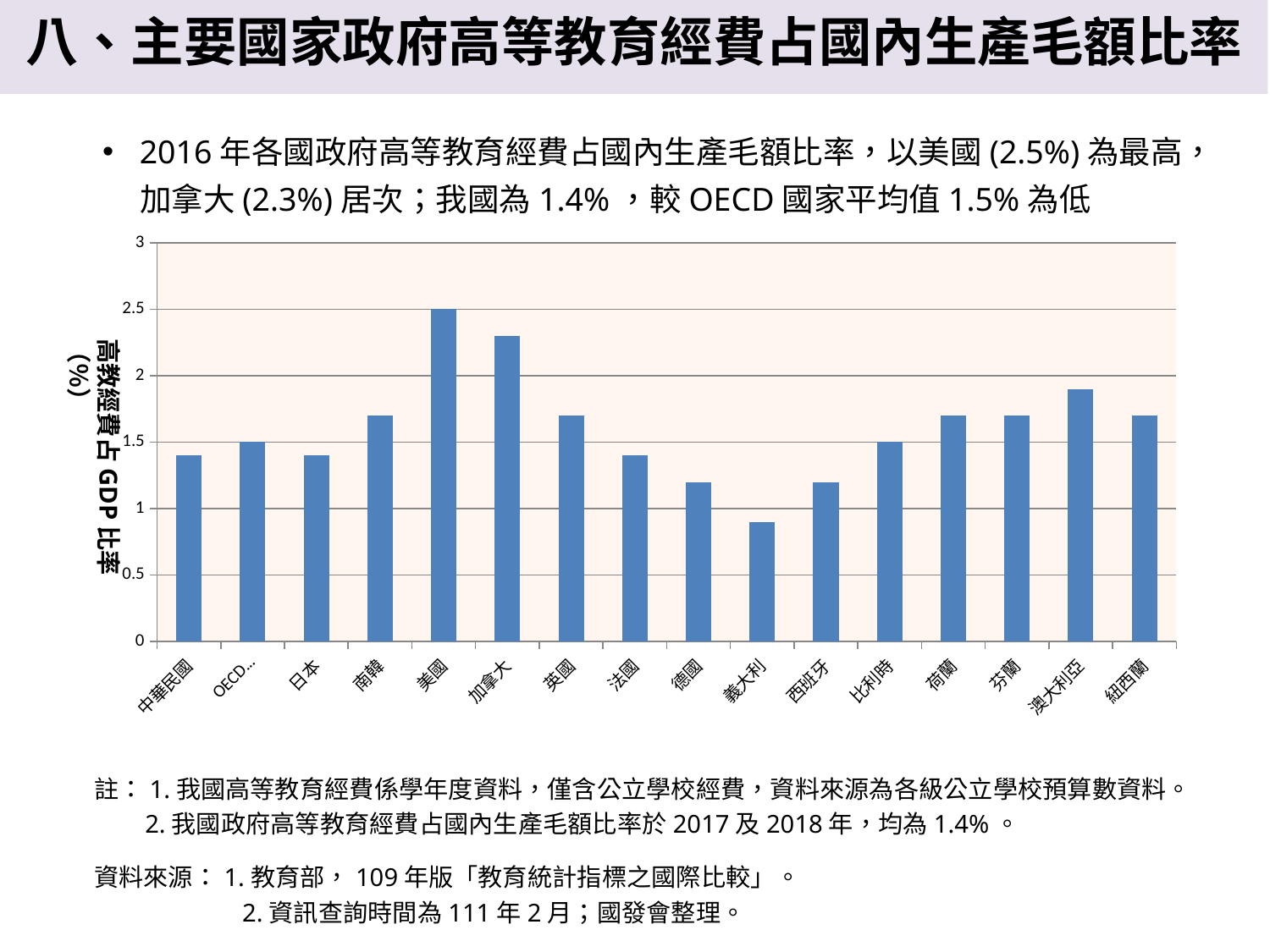
Is the value for 義大利 greater or less than 1? less Which category has the highest bar? 美國 What is the label on the vertical axis of the chart? 高教經費占GDP比率(%) Which is larger, the value for 南韓 or the value for 日本? 南韓 How many countries/categories are plotted along the x axis? 16 What is the difference between the values for 美國 and 加拿大? 0.2% What is the value for 中華民國? 1.4% Is the value for 荷蘭 greater or less than 1.5? greater What is the value for 美國? 2.5% Which category has the lowest bar? 義大利 What is the value for 加拿大? 2.3% What kind of chart is shown on the slide? bar chart